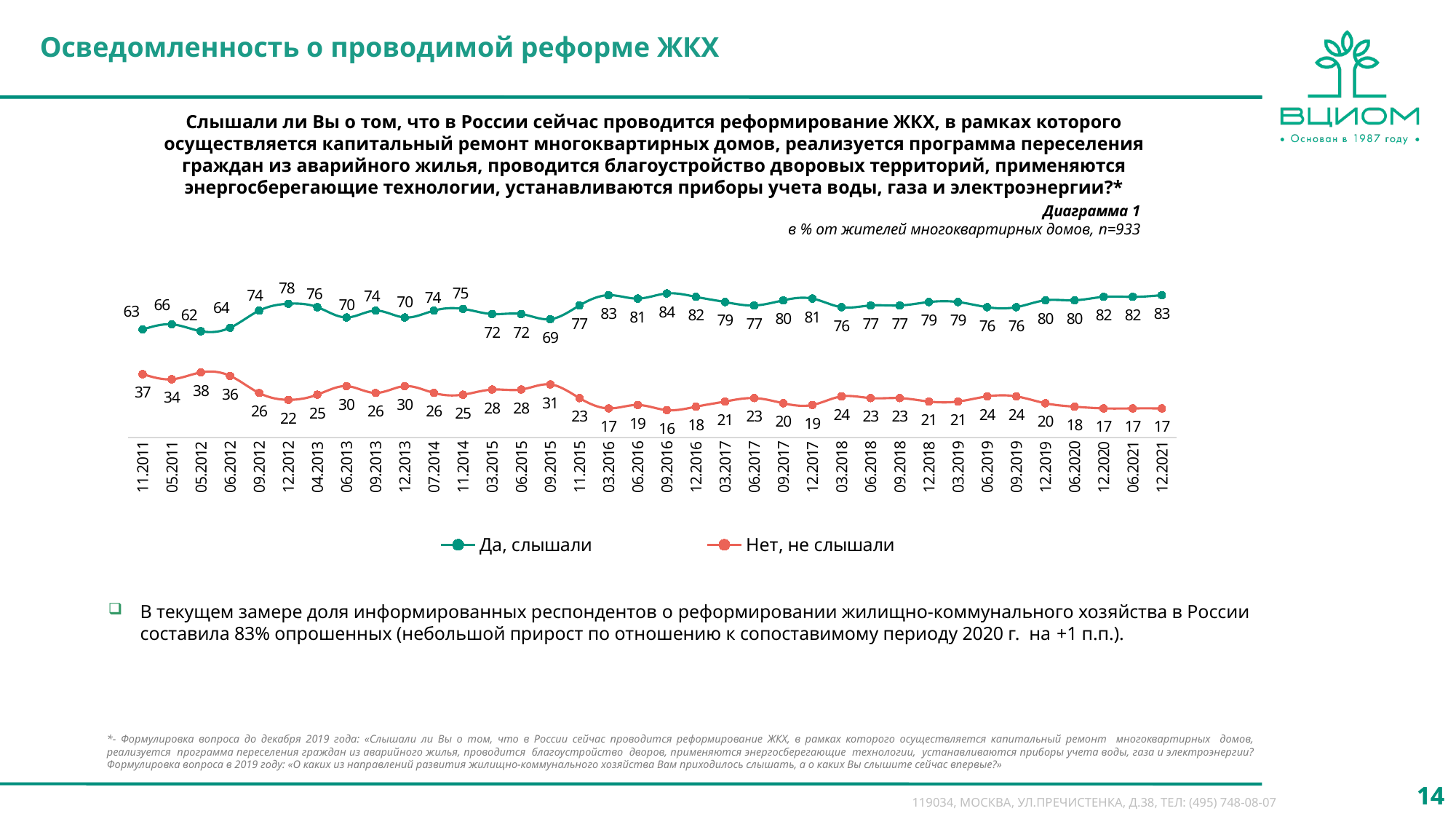
Which is larger: "Да, слышали" in 09.2012 or in 12.2012? 12.2012 What is the value of "Да, слышали" for 12.2021? 83 How many series does the legend list? 2 What type of chart is shown on the slide? line chart What is the value of "Нет, не слышали" for 09.2015? 31 In which period does "Нет, не слышали" reach its highest value? 05.2012 What is the sample size (n) stated in the chart subtitle? n=933 How many time points are plotted on the x axis? 36 In which period does "Да, слышали" reach its highest value? 09.2016 What is the difference between "Да, слышали" and "Нет, не слышали" in 12.2021? 66 What is the value of "Да, слышали" for 11.2011? 63 In which period does "Да, слышали" have its lowest value? 05.2012